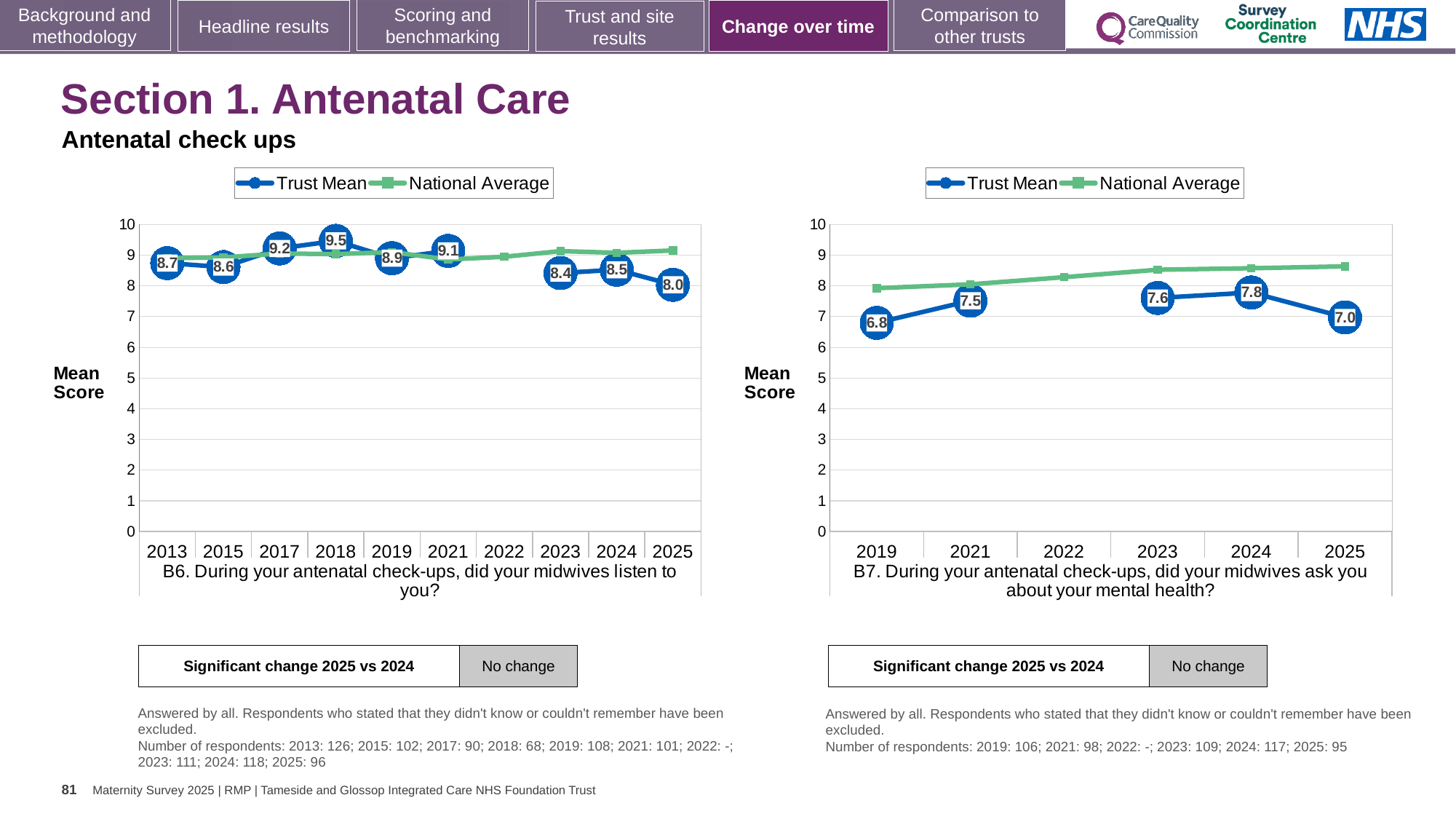
What type of chart is the B7 chart (right)? Line chart In the B6 chart (left), what is the Trust Mean for 2025? 8.0 In the B6 chart (left), what is the Trust Mean for 2018? 9.5 In the B7 chart (right), which is larger: the Trust Mean for 2021 or the Trust Mean for 2025? 2021 How many years are shown on the x axis of the B6 chart (left)? 10 In the B7 chart (right), what is the Trust Mean for 2024? 7.8 In the B7 chart (right), is the National Average for 2025 greater or less than 8? greater In the B6 chart (left), what is the difference between the Trust Mean for 2018 and the Trust Mean for 2025? 1.5 In the B6 chart (left), which year has the highest labelled Trust Mean? 2018 In the B7 chart (right), what is the Trust Mean for 2019? 6.8 In the B7 chart (right), which year has the lowest labelled Trust Mean? 2019 In the B7 chart (right), what is the difference between the Trust Mean for 2024 and the Trust Mean for 2025? 0.8